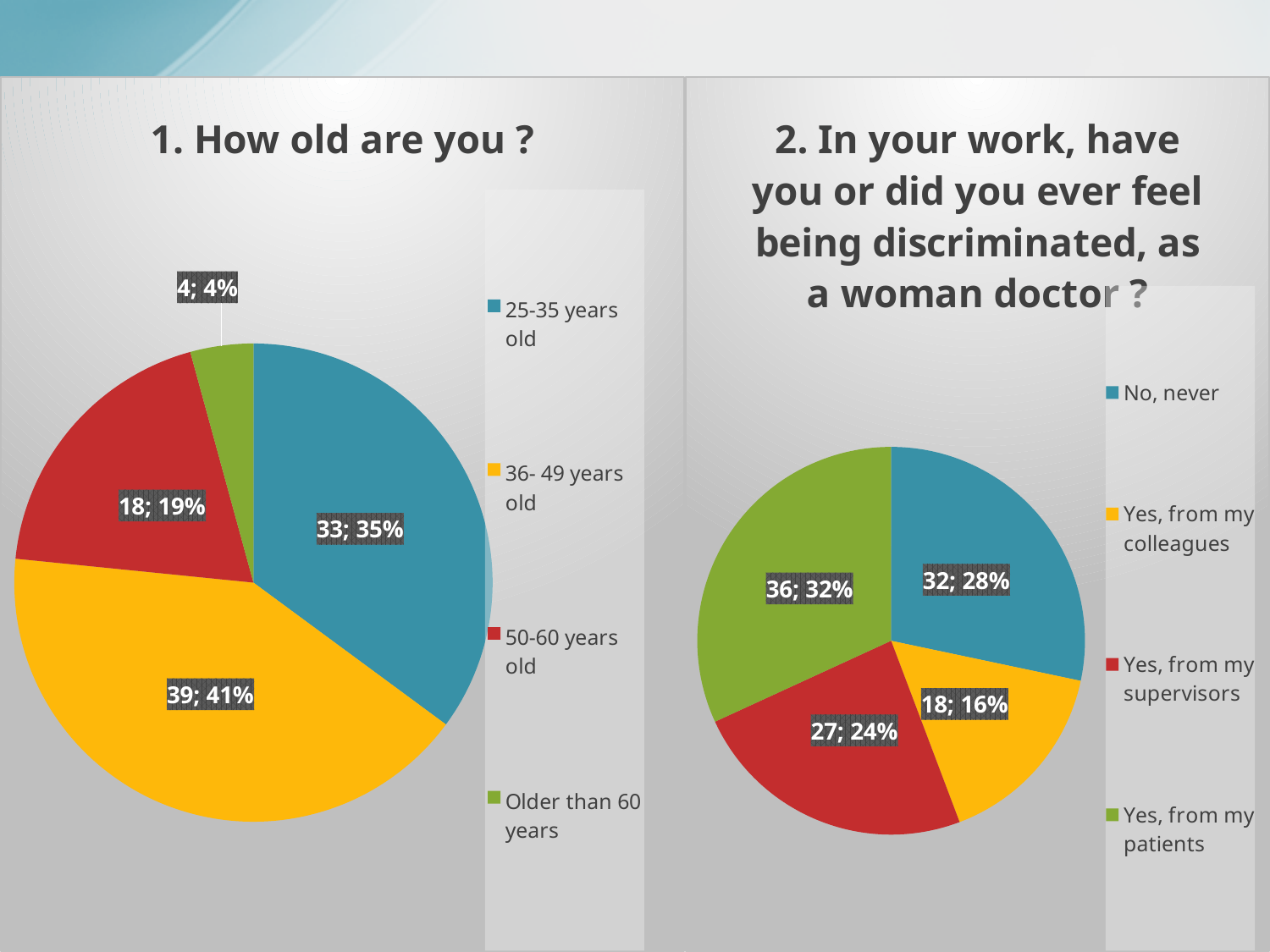
In the chart on the right (question 2), which is larger: "No, never" or "Yes, from my supervisors"? No, never In the chart on the right (question 2), which response has the largest slice? Yes, from my patients In the chart titled "1. How old are you ?", what share of the pie is the 25-35 years old slice? 35% In the chart titled "1. How old are you ?", which age group has the smallest slice? Older than 60 years In the chart titled "1. How old are you ?", what is the difference in count between the 36- 49 years old and 50-60 years old slices? 21 In the chart titled "1. How old are you ?", which age group has the largest slice? 36- 49 years old In the chart titled "1. How old are you ?", what is the data label for the 36- 49 years old slice? 39; 41% In the chart titled "1. How old are you ?", how many categories does the pie have? 4 In the chart on the right (question 2), what colour is the "Yes, from my supervisors" slice? Red What type of chart is used on the right side of the slide (question 2)? Pie chart In the chart on the right (question 2), what is the data label for the "Yes, from my patients" slice? 36; 32% In the chart on the right (question 2), which response has the smallest slice? Yes, from my colleagues